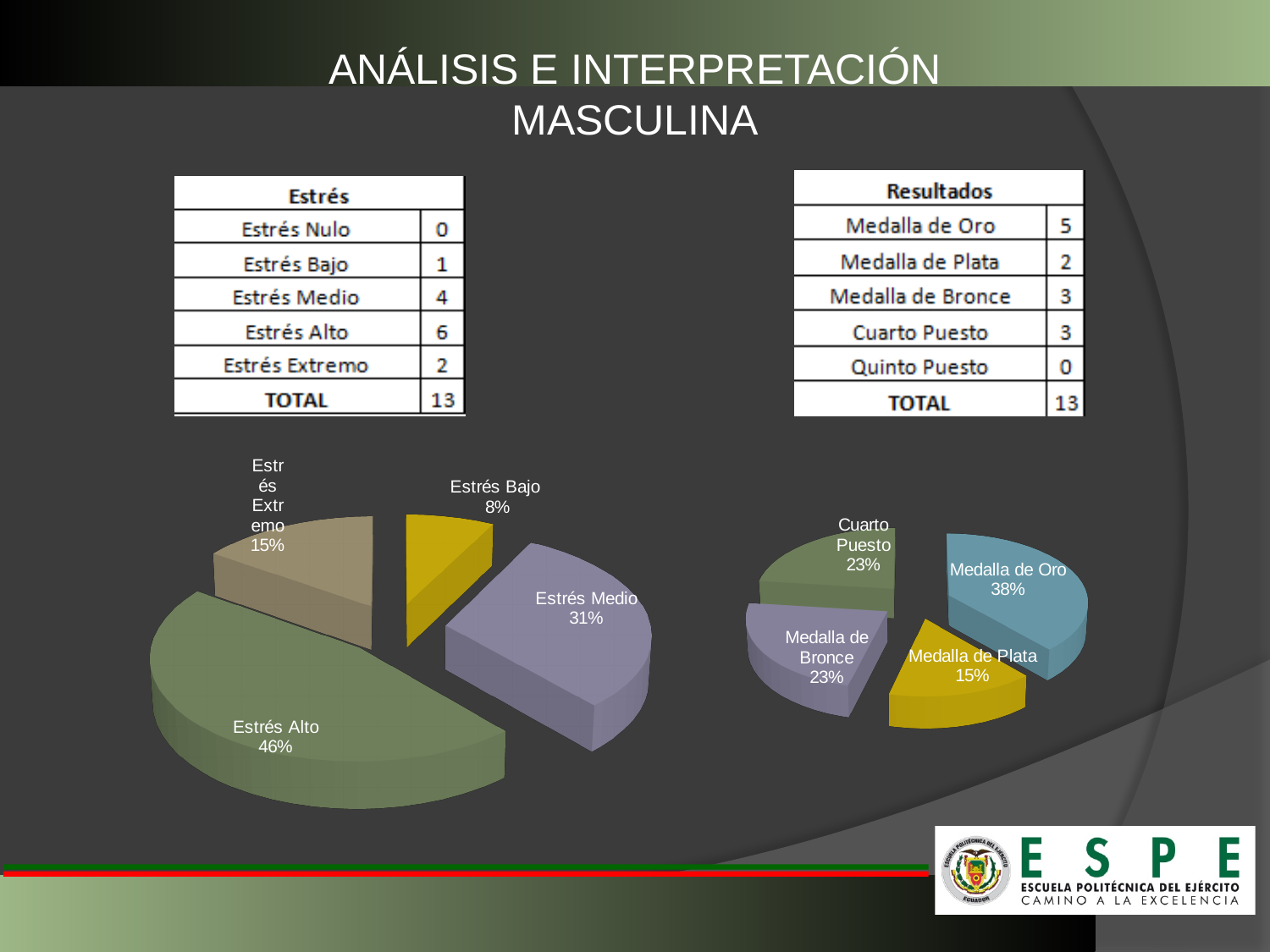
In the pie chart on the right, which category has the largest slice? Medalla de Oro In the pie chart on the left, what share is labelled for Estrés Bajo? 8% In the pie chart on the right, what is the difference in percentage points between Medalla de Oro and Cuarto Puesto? 15 In the pie chart on the right, which is larger, Medalla de Bronce or Medalla de Plata? Medalla de Bronce In the pie chart on the left, what share is labelled for Estrés Alto? 46% In the pie chart on the left, which category has the largest slice? Estrés Alto In the pie chart on the left, what is the difference in percentage points between Estrés Medio and Estrés Extremo? 16 In the pie chart on the left, how many slices are shown? 4 In the pie chart on the right, what share is labelled for Medalla de Oro? 38% In the pie chart on the left, which category has the smallest slice? Estrés Bajo In the pie chart on the right, what share is labelled for Medalla de Plata? 15% What type of chart is shown on the right side of the slide? Pie chart